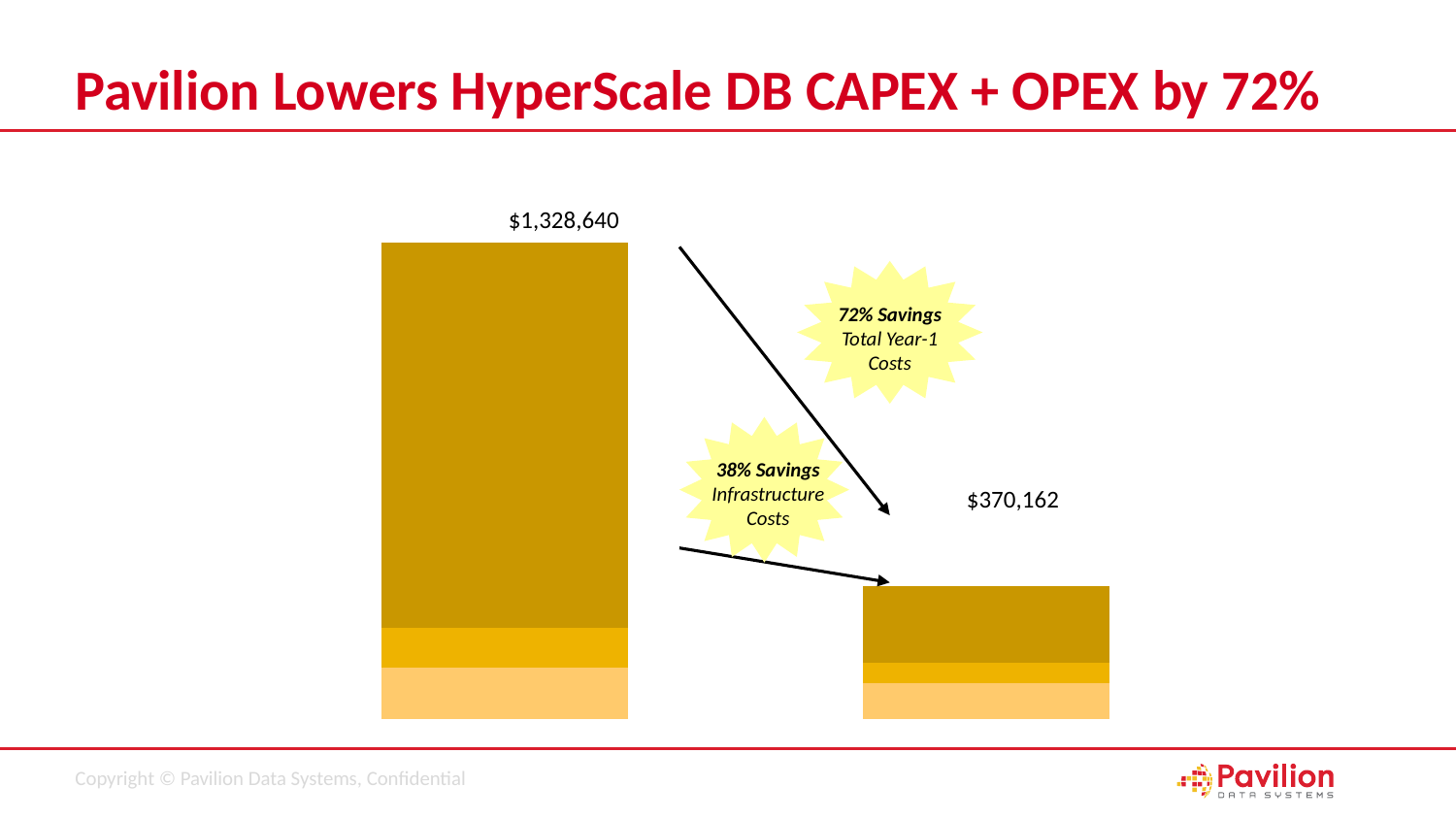
What kind of chart is shown on the slide? bar chart What is the difference between the left bar's total and the right bar's total? $958,478 What percentage savings in Total Year-1 Costs is called out on the chart? 72% How many stacked segments make up each bar? 3 What is the total value labeled on the left bar? $1,328,640 How many bars are plotted in the chart? 2 Which bar has the lowest total value? right bar Which bar has the higher total, the left bar or the right bar? left bar What percentage savings in Infrastructure Costs is called out on the chart? 38% What is the total value labeled on the right bar? $370,162 Do the bar totals rise or fall from the left bar to the right bar? fall